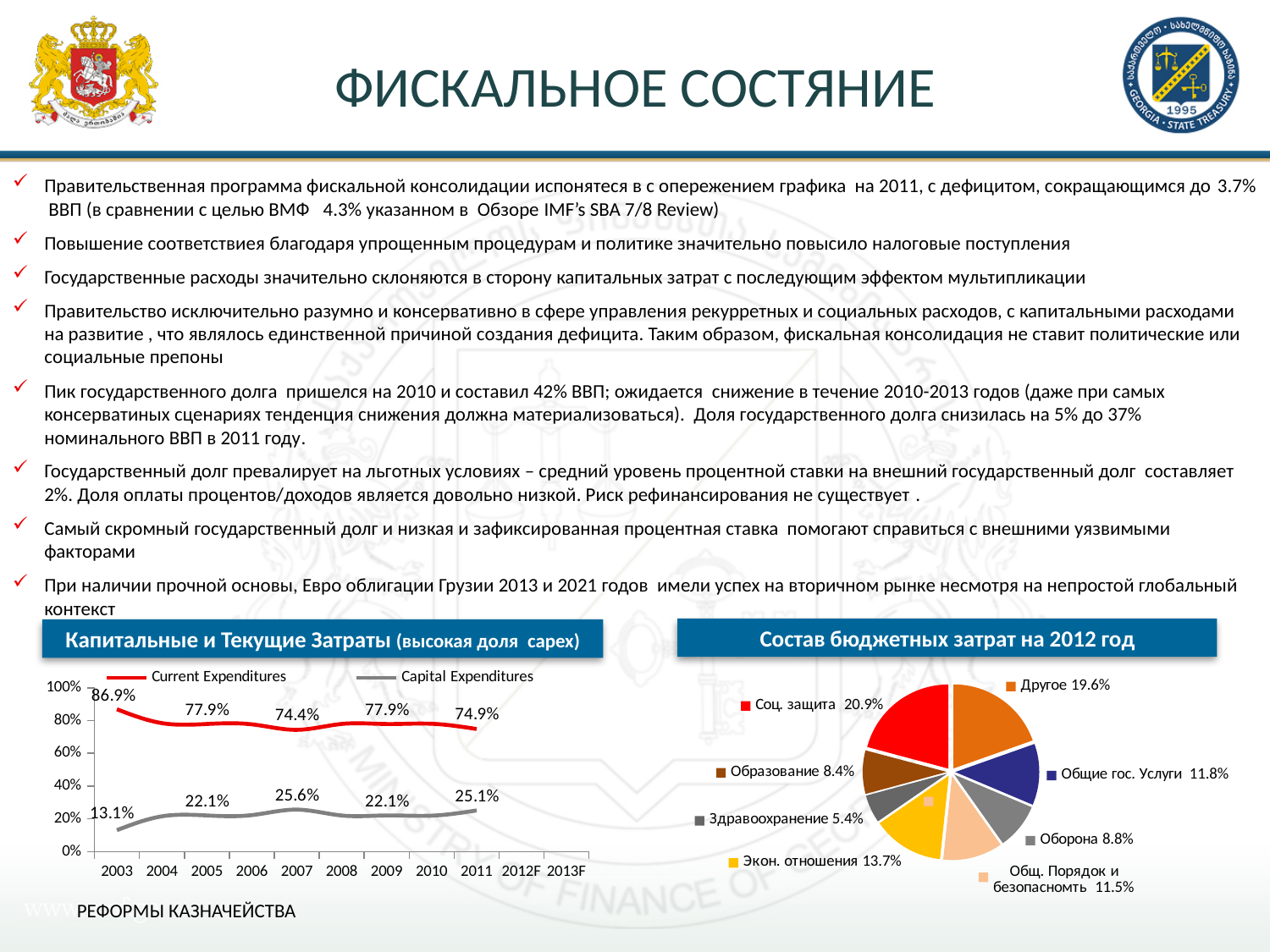
In the chart 'Капитальные и Текущие Затраты', does the Current Expenditures line generally rise or fall from 2003 to 2011? Fall In the chart 'Капитальные и Текущие Затраты', what is the value for Current Expenditures in 2003? 86.9% In the chart 'Капитальные и Текущие Затраты', what is the value for Capital Expenditures in 2003? 13.1% In the pie chart 'Состав бюджетных затрат на 2012 год', which category has the largest share? Соц. защита In the pie chart 'Состав бюджетных затрат на 2012 год', which category has the smallest share? Здравоохранение In the chart 'Капитальные и Текущие Затраты', what is the difference between Current Expenditures and Capital Expenditures in 2003? 73.8% What kind of chart is 'Капитальные и Текущие Затраты'? Line chart In the chart 'Капитальные и Текущие Затраты', which series has the higher value in 2003, Current Expenditures or Capital Expenditures? Current Expenditures How many slices does the pie chart 'Состав бюджетных затрат на 2012 год' have? 8 In the pie chart 'Состав бюджетных затрат на 2012 год', what share does Соц. защита have? 20.9% In the chart 'Капитальные и Текущие Затраты', how many series does the legend list? 2 In the pie chart 'Состав бюджетных затрат на 2012 год', what is the difference between the shares of Соц. защита and Другое? 1.3%